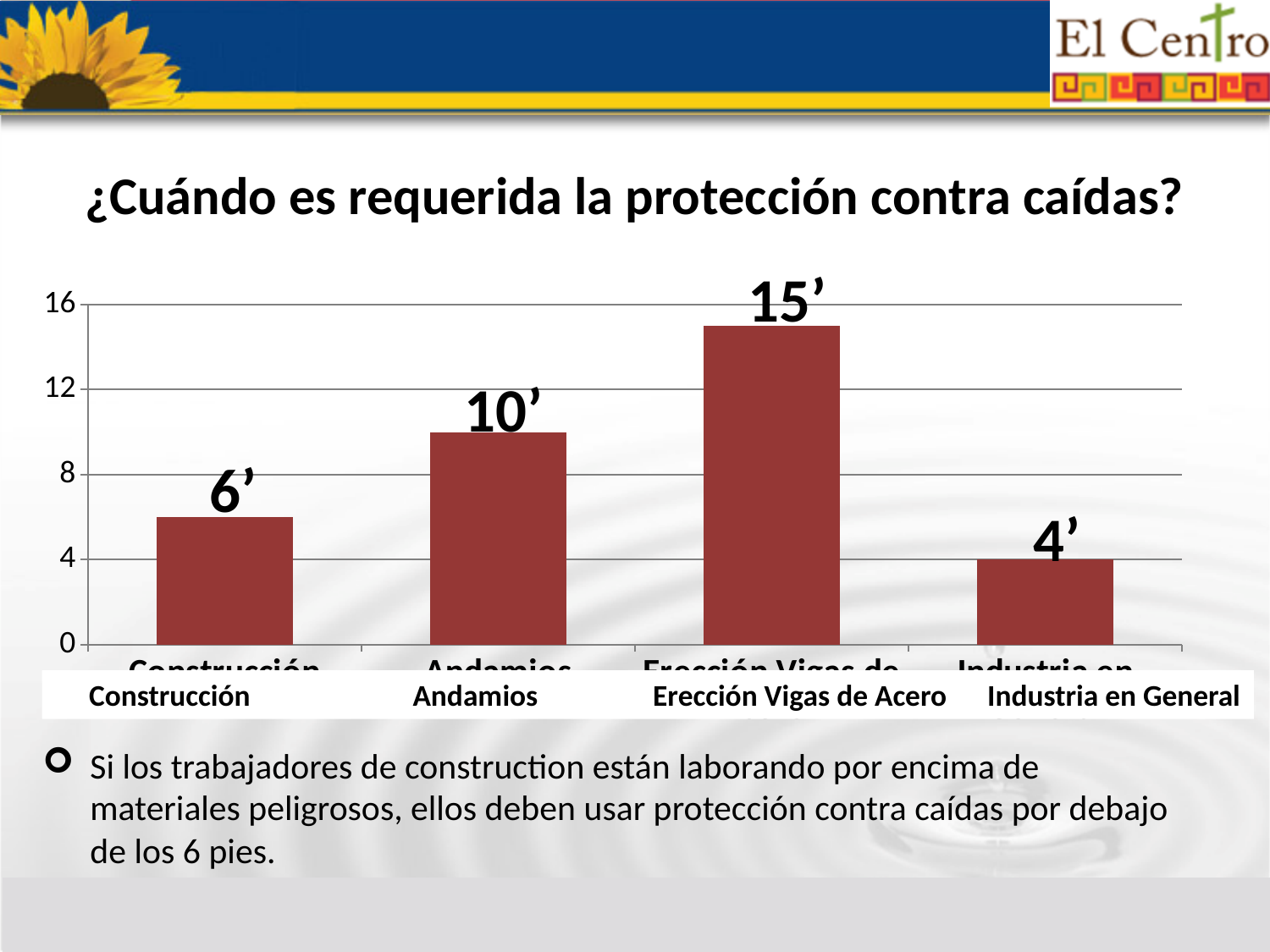
How many categories are shown in the chart? 4 Which category has the lowest value? Industria en General What is the title of the slide containing the chart? ¿Cuándo es requerida la protección contra caídas? Which category has the highest value? Erección Vigas de Acero Which is larger, the value for Andamios or the value for Industria en General? Andamios What kind of chart is shown on the slide? bar chart What is the difference between the values for Erección Vigas de Acero and Construcción? 9' What is the value for Erección Vigas de Acero? 15' What is the value for Construcción? 6' What is the value for Andamios? 10' Is the value for Andamios greater or less than 8? greater What is the value for Industria en General? 4'